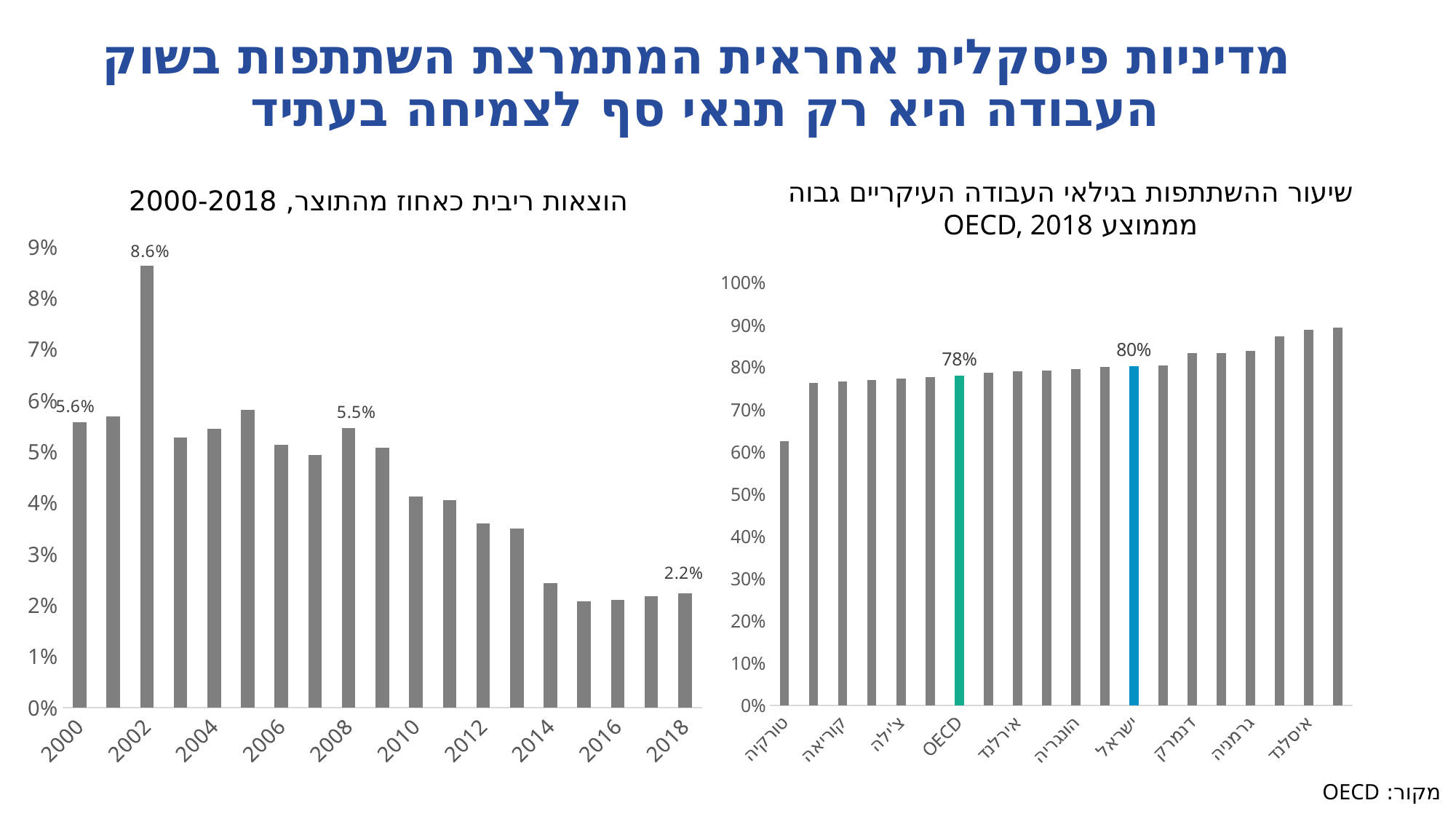
In the right chart (participation rate in prime working ages, 2018), which country has the lowest value? טורקיה In the left chart (interest expenses as a percent of GDP), do the values generally rise or fall from 2002 to 2018? fall In the right chart (participation rate in prime working ages, 2018), is the value for טורקיה greater or less than 70%? less In the left chart (interest expenses as a percent of GDP), how many years (bars) are plotted? 19 In the left chart (interest expenses as a percent of GDP), what is the value for 2018? 2.2% In the left chart (interest expenses as a percent of GDP), what is the difference between the 2002 value and the 2018 value? 6.4% What kind of chart is the left chart, 'הוצאות ריבית כאחוז מהתוצר, 2000-2018'? bar chart In the left chart (interest expenses as a percent of GDP), is the value for 2014 greater or less than 3%? less In the right chart (participation rate in prime working ages, 2018), what is the value for OECD? 78% In the left chart (interest expenses as a percent of GDP), what is the value for 2002? 8.6% In the left chart (interest expenses as a percent of GDP), which year has the highest value? 2002 In the right chart (participation rate in prime working ages, 2018), what is the value for ישראל? 80%